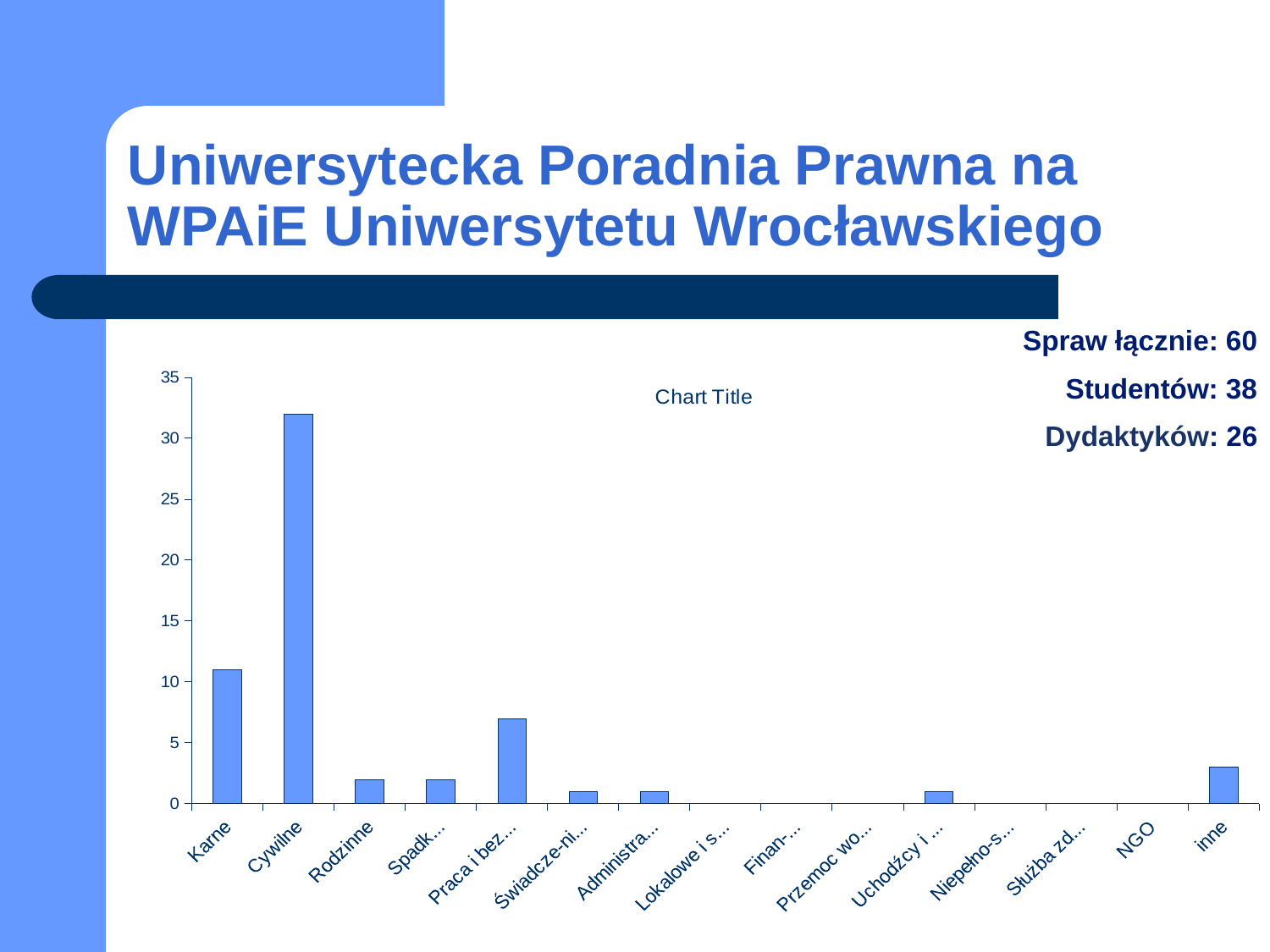
Which is larger, the value for Karne or the value for inne? Karne Is the value for Cywilne greater or less than 30? greater Which category has the highest bar? Cywilne Is the value for Karne greater or less than 5? greater What kind of chart is shown on the slide? bar chart Is the value for Praca i bez... greater or less than 10? less How many categories are shown on the x axis? 15 Which is larger, the value for Karne or the value for Cywilne? Cywilne What title is printed on the chart? Chart Title Which is larger, the value for Rodzinne or the value for Praca i bez...? Praca i bez...